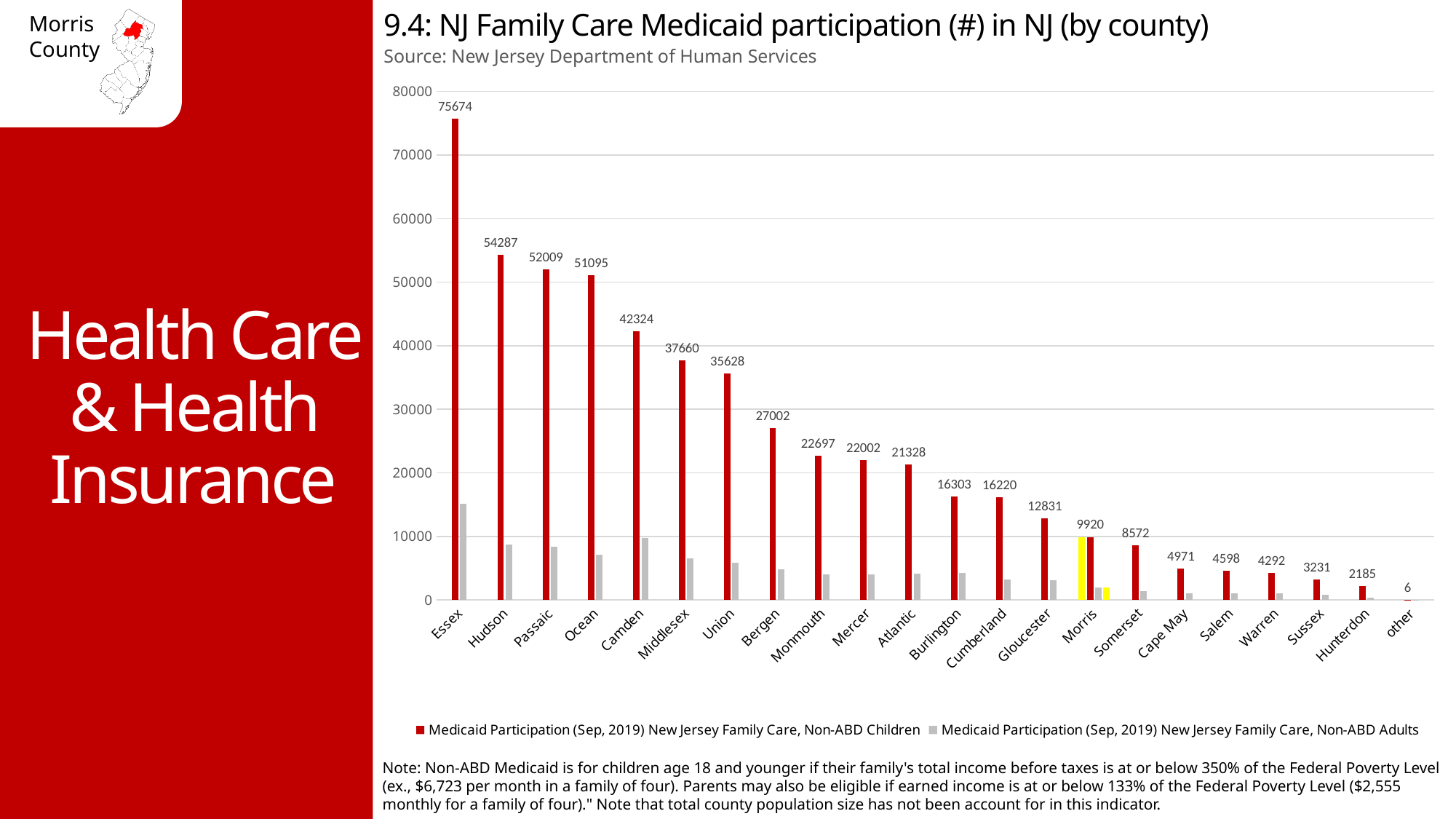
Is the Non-ABD Adults participation value for Essex greater or less than 10000? greater What is the Non-ABD Children Medicaid participation value for Camden county? 42324 How many categories are shown on the x axis of the chart? 22 What is the Non-ABD Children Medicaid participation value for Morris county? 9920 Which county has the highest Non-ABD Children Medicaid participation? Essex Which county has a larger Non-ABD Children participation, Bergen or Monmouth? Bergen Do the Non-ABD Children values rise or fall moving from left to right along the x axis? Fall Which county (excluding 'other') has the lowest Non-ABD Children Medicaid participation? Hunterdon Is the Non-ABD Adults participation value for Morris greater or less than 10000? less How many series does the legend list? 2 What kind of chart is shown on the slide? Bar chart What is the difference in Non-ABD Children participation between Essex and Hudson? 21387